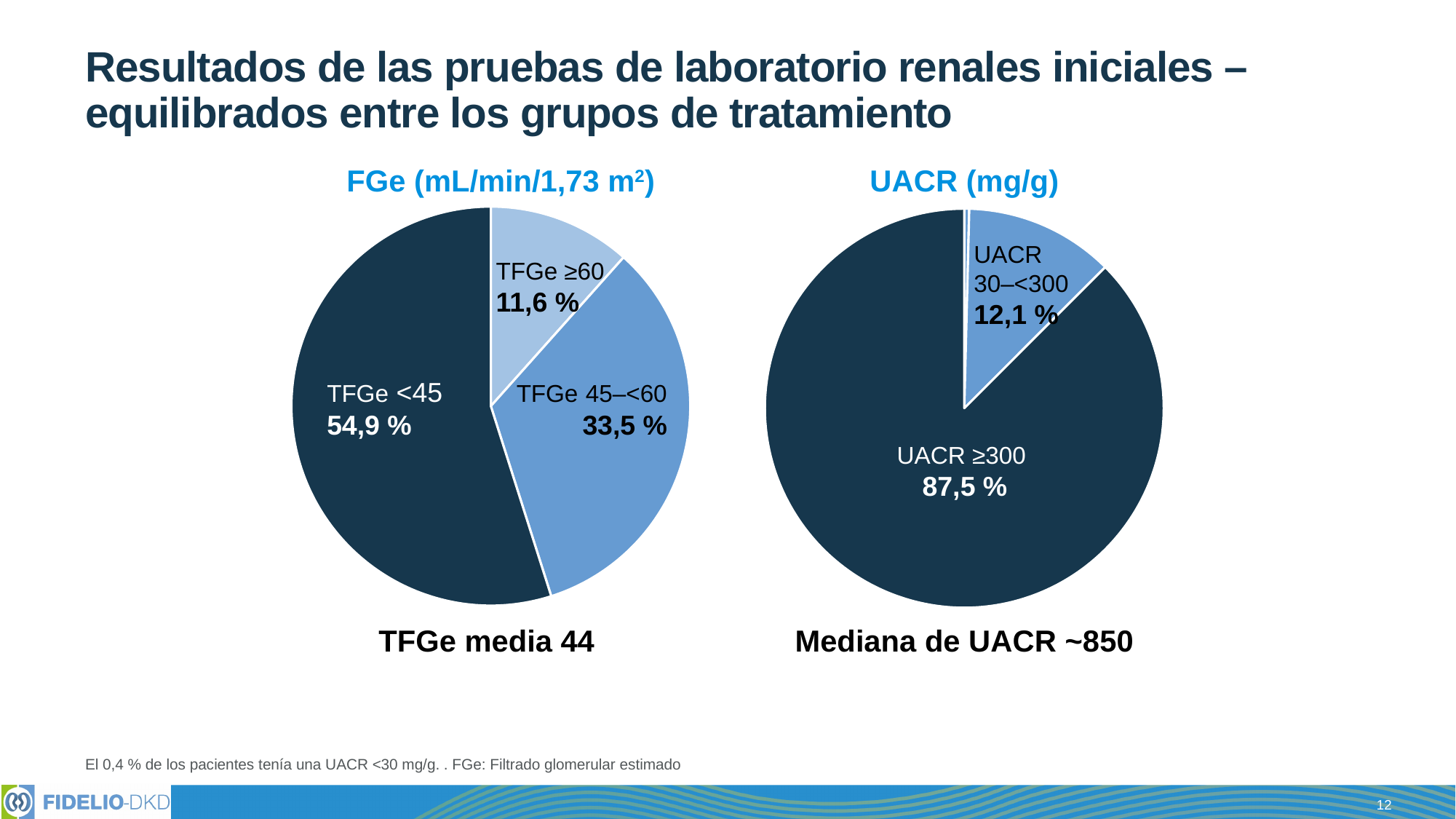
What type of chart is used for the UACR (mg/g) data? Pie chart In the UACR (mg/g) pie chart, what is the difference in percentage points between UACR ≥300 and UACR 30–<300? 75,4 % In the FGe (mL/min/1,73 m²) pie chart, what is the difference in percentage points between TFGe <45 and TFGe 45–<60? 21,4 % How many labeled categories does the FGe (mL/min/1,73 m²) pie chart show? 3 In the FGe (mL/min/1,73 m²) pie chart, which is larger: TFGe 45–<60 or TFGe ≥60? TFGe 45–<60 In the UACR (mg/g) pie chart, what percentage of patients had UACR 30–<300? 12,1 % In the UACR (mg/g) pie chart, what percentage of patients had UACR ≥300? 87,5 % In the FGe (mL/min/1,73 m²) pie chart, what percentage of patients had TFGe ≥60? 11,6 % In the FGe (mL/min/1,73 m²) pie chart, what percentage of patients had TFGe <45? 54,9 % In the FGe (mL/min/1,73 m²) pie chart, which category has the largest share? TFGe <45 What is the mean TFGe value stated below the FGe (mL/min/1,73 m²) pie chart? 44 In the FGe (mL/min/1,73 m²) pie chart, which category has the smallest share? TFGe ≥60